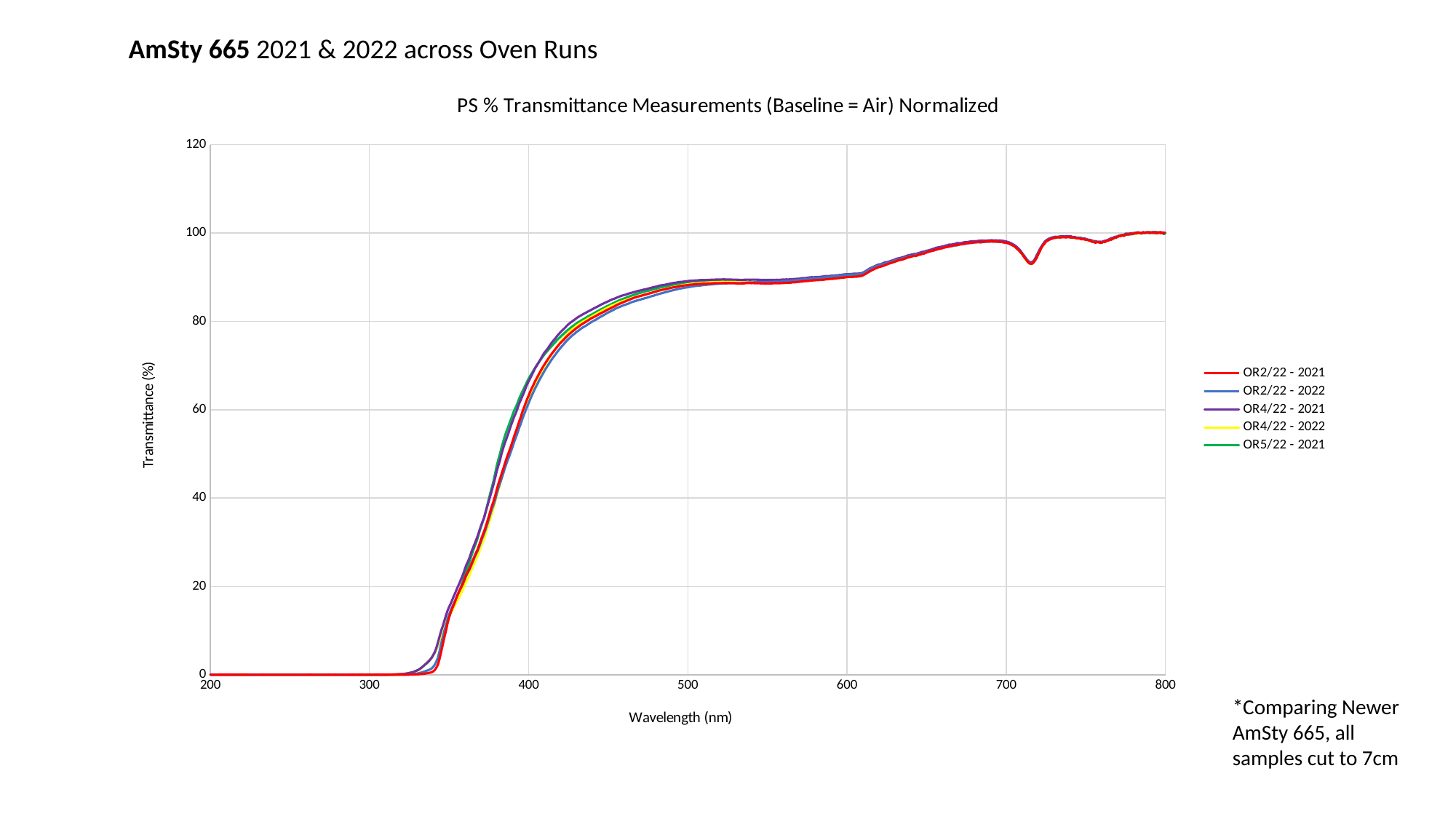
Is the value for OR4/22 - 2021 at 400 nm greater or less than 40? greater What is the label of the x axis? Wavelength (nm) How many series does the legend list? 5 Do the transmittance values generally rise or fall as wavelength increases from 300 nm to 500 nm? Rise Is the value for OR5/22 - 2021 at 700 nm greater or less than 80? greater What is the highest tick value shown on the y axis? 120 Is the value for OR2/22 - 2022 at 400 nm greater or less than 80? less What kind of chart is shown on the slide? Line chart What is the title of the chart? PS % Transmittance Measurements (Baseline = Air) Normalized